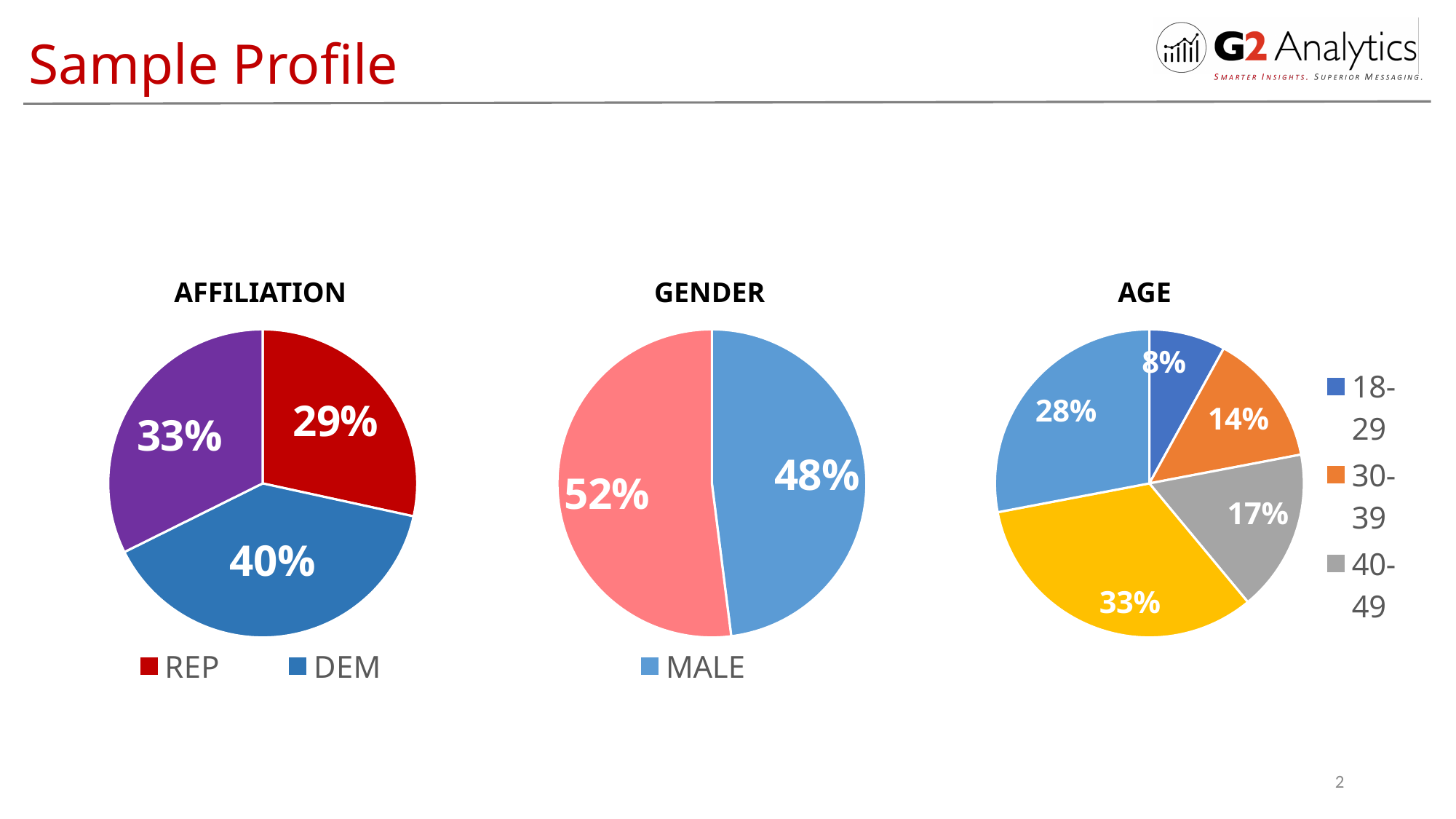
In the AFFILIATION chart, what is the difference in percentage points between the DEM and REP shares? 11 In the GENDER chart, what is the largest slice's value? 52% In the AFFILIATION chart, which legend category has the larger share, REP or DEM? DEM In the GENDER chart, what share of the sample is MALE? 48% How many slices does the AGE pie chart have? 5 In the AGE chart, what is the difference in percentage points between the 30-39 and 18-29 shares? 6 What kind of chart is the GENDER chart? Pie chart In the AGE chart, what share of the sample is aged 18-29? 8% In the AGE chart, what share of the sample is aged 40-49? 17% How many slices does the AFFILIATION pie chart have? 3 In the AFFILIATION chart, what share of the sample is DEM? 40% In the AFFILIATION chart, what share of the sample is REP? 29%